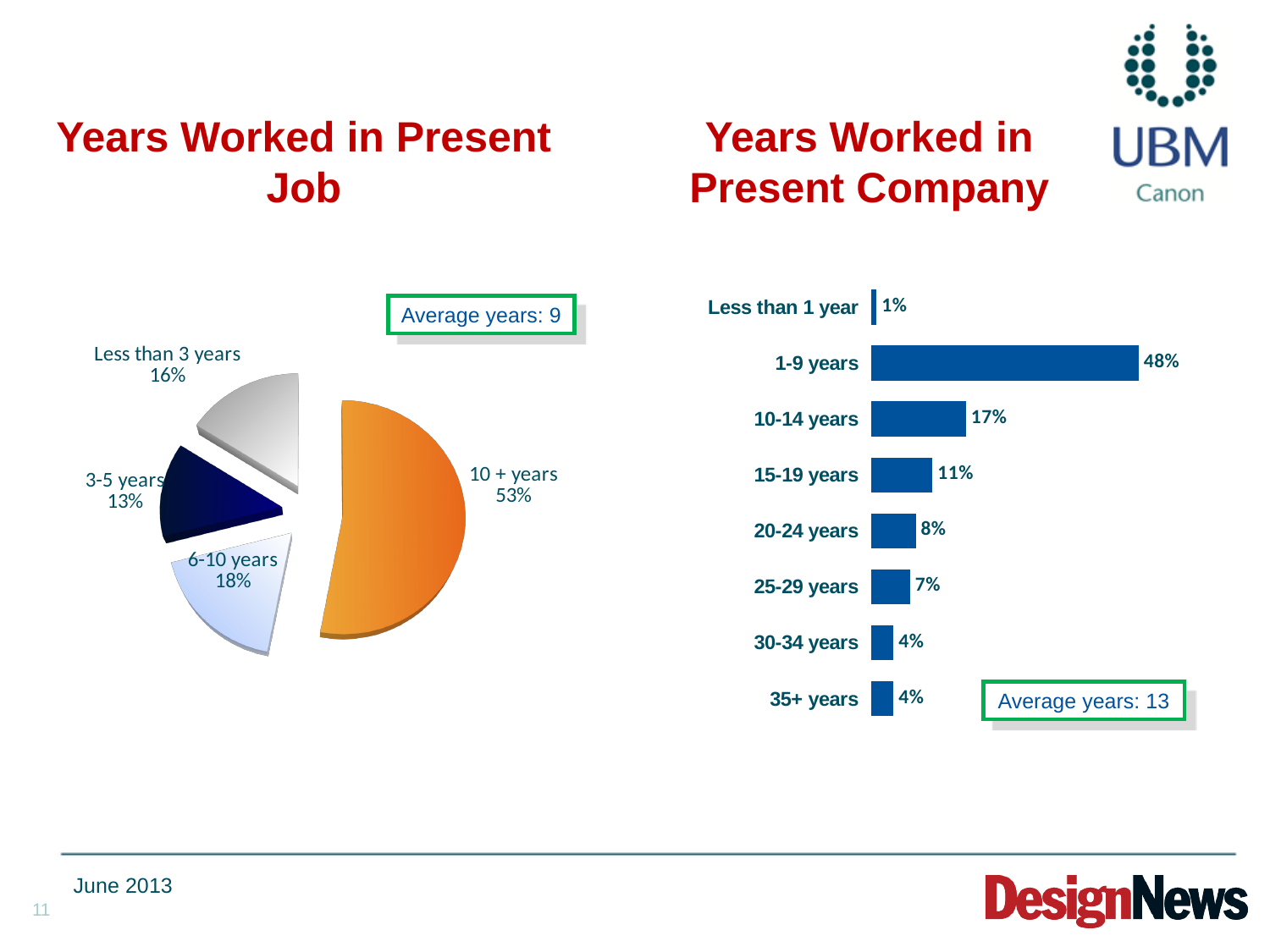
In the 'Years Worked in Present Job' pie chart, what share is shown for 10 + years? 53% In the 'Years Worked in Present Company' bar chart, what is the value for 10-14 years? 17% In the 'Years Worked in Present Job' pie chart, how many slices are there? 4 In the 'Years Worked in Present Job' pie chart, what share is shown for 6-10 years? 18% In the 'Years Worked in Present Company' bar chart, what is the value for Less than 1 year? 1% What type of chart is 'Years Worked in Present Job'? Pie chart In the 'Years Worked in Present Job' pie chart, which category has the smallest share? 3-5 years In the 'Years Worked in Present Job' chart, what is the difference between the shares for Less than 3 years and 3-5 years? 3% In the 'Years Worked in Present Company' bar chart, which is larger: 15-19 years or 20-24 years? 15-19 years In the 'Years Worked in Present Company' bar chart, which category has the highest value? 1-9 years In the 'Years Worked in Present Company' bar chart, how many categories are shown? 8 In the 'Years Worked in Present Company' bar chart, what is the difference between the values for 1-9 years and 10-14 years? 31%